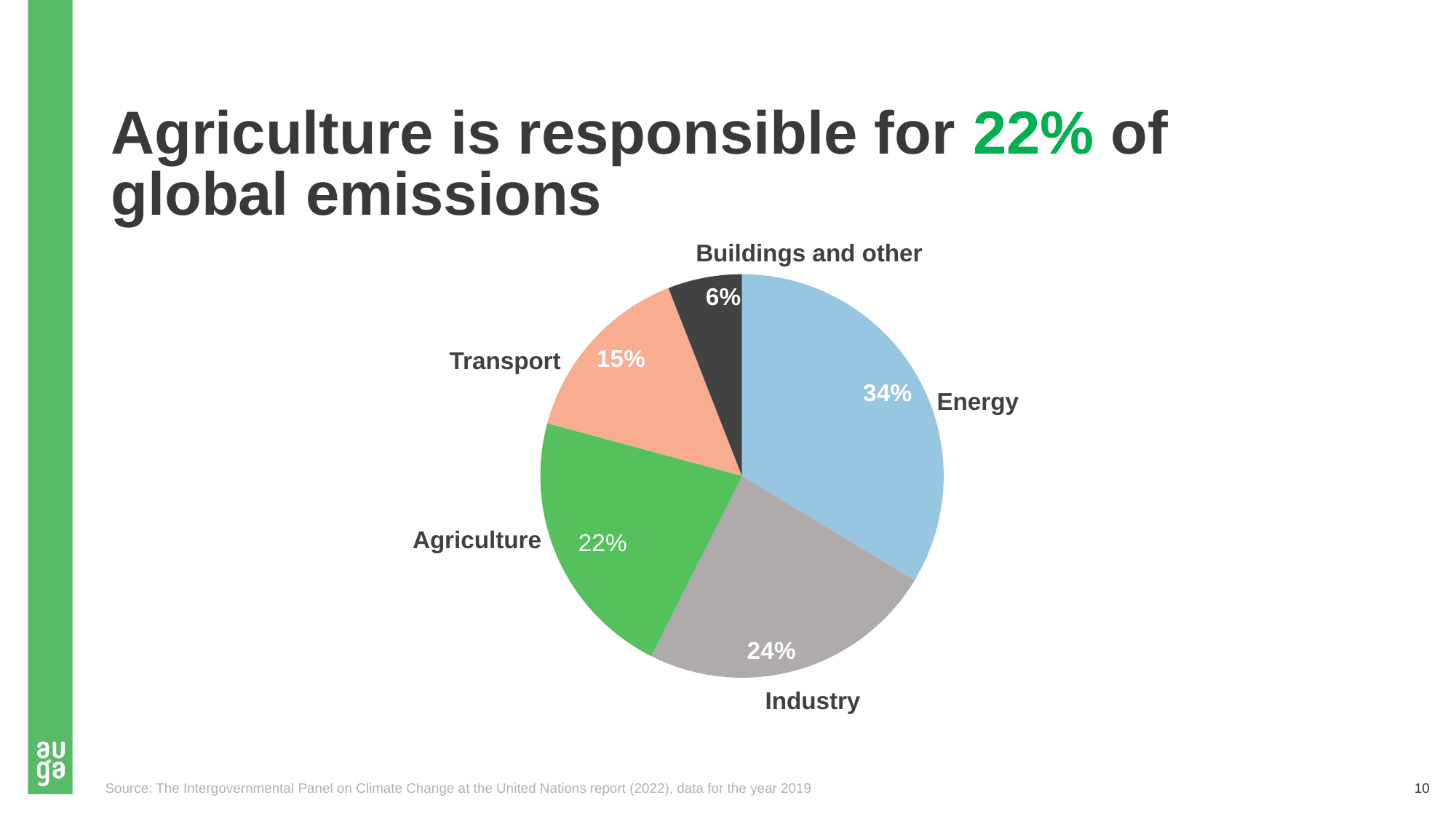
What percentage is shown for Industry? 24% What share of global emissions does the Energy slice represent? 34% What colour is the Agriculture slice? Green What is the difference in percentage points between Industry and Transport? 9 How many sectors are shown in the pie chart? 5 What type of chart is shown on the slide? Pie chart Which sector has the largest share of global emissions? Energy How many percentage points larger is the Energy share than the Agriculture share? 12 What percentage is shown for Transport? 15% Which sector has the smallest share of global emissions? Buildings and other What percentage is shown for Buildings and other? 6% Which is larger, the Industry share or the Agriculture share? Industry